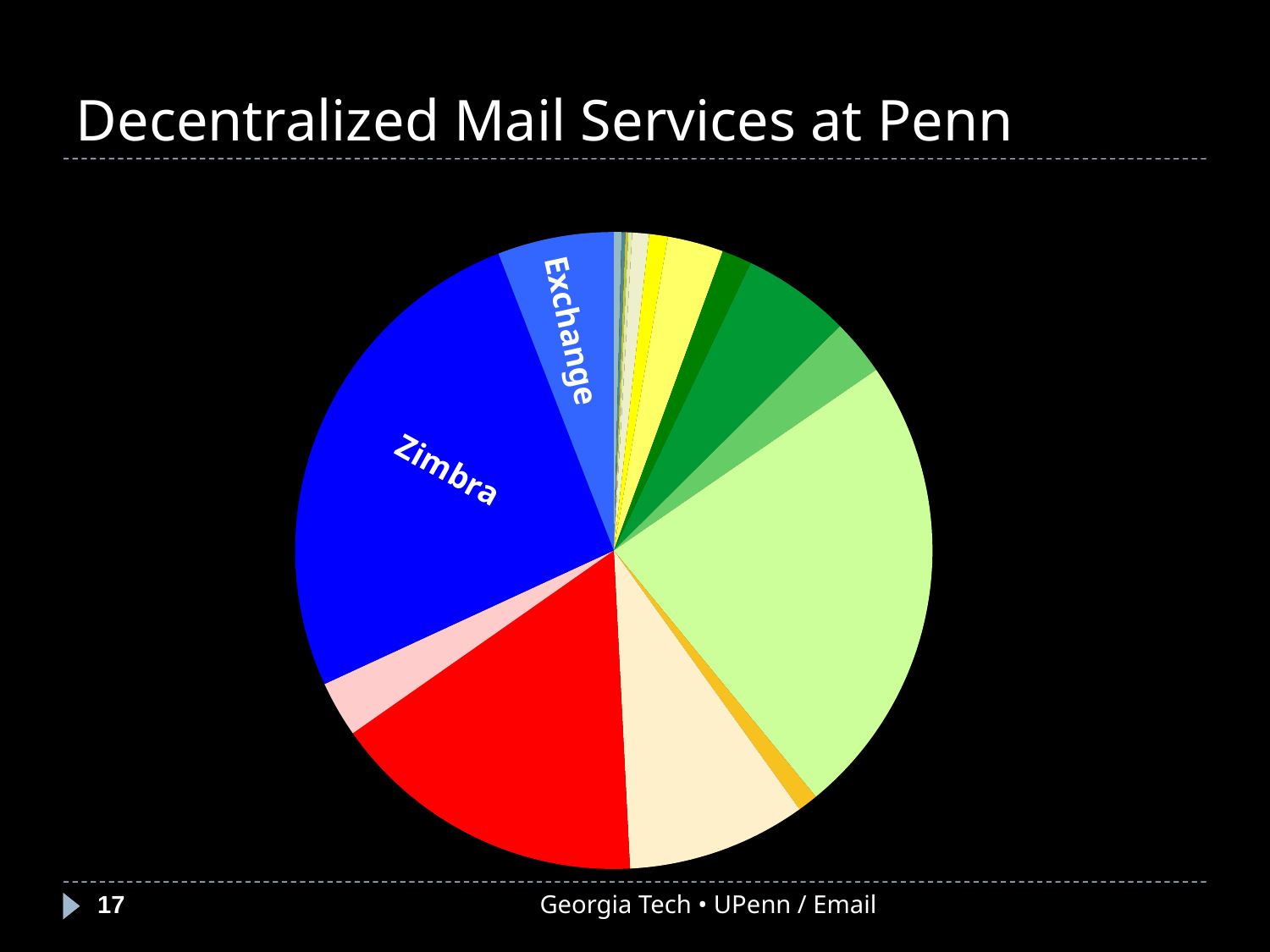
What kind of chart is shown on the slide? pie chart What colour is the Zimbra slice of the pie chart? blue Is the Exchange slice larger or smaller than the Zimbra slice? smaller How many slices of the pie chart are labeled with a name? 2 What is the title of the slide containing the pie chart? Decentralized Mail Services at Penn Which of the two labeled slices, Zimbra or Exchange, is larger? Zimbra